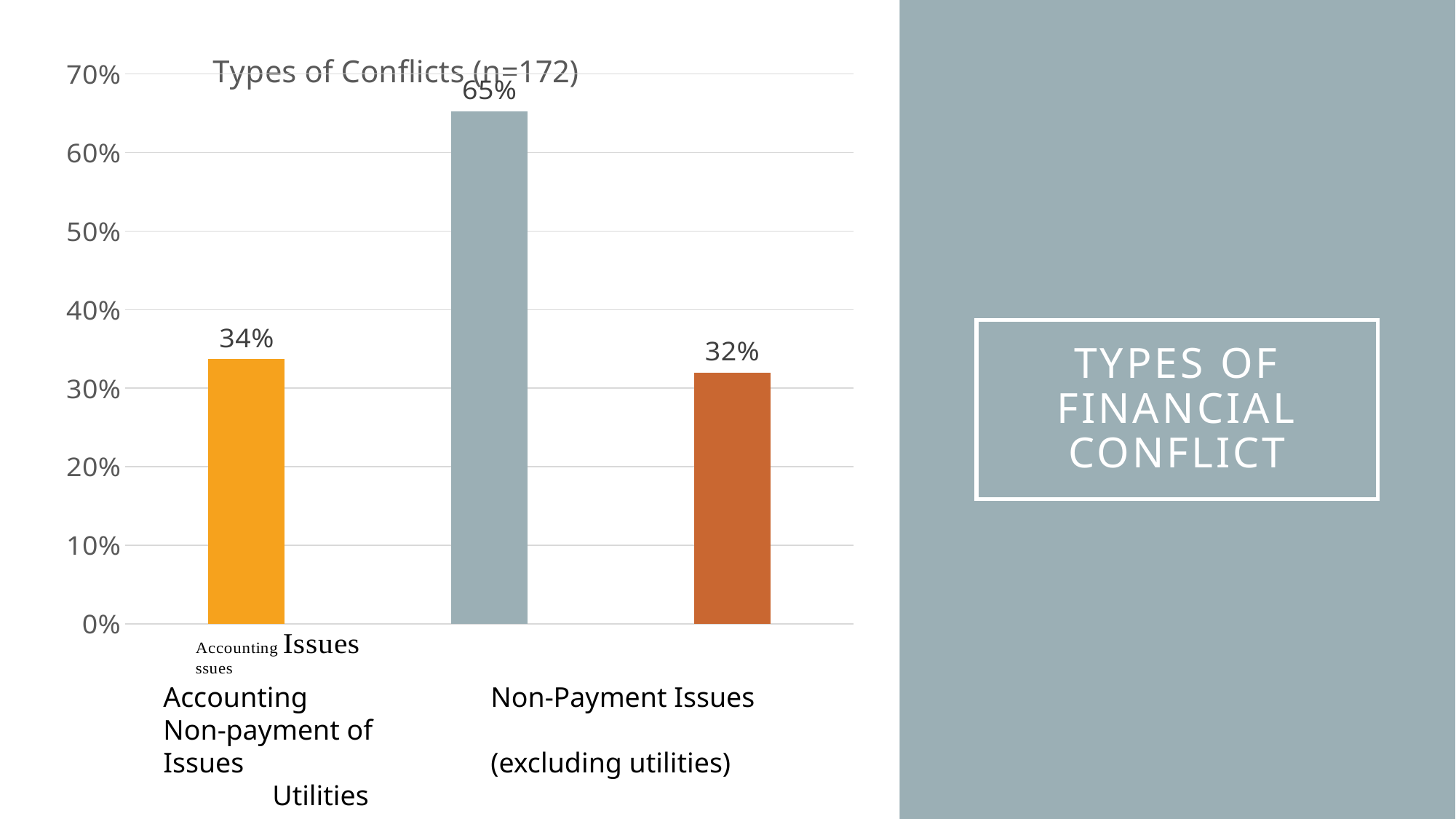
How many percentage points higher is Non-Payment Issues (excluding utilities) than Accounting Issues? 31 percentage points How many bars are plotted in the Types of Conflicts chart? 3 Which category has the highest percentage in the Types of Conflicts chart? Non-Payment Issues (excluding utilities) Is the value for Non-Payment Issues (excluding utilities) greater or less than 60%? greater What is the difference between the Accounting Issues bar (34%) and the rightmost bar (32%)? 2 percentage points What value is labelled on the rightmost (dark orange) bar of the chart? 32% Which bar in the chart has the lowest value? The rightmost (dark orange) bar, 32% What is the title of the chart on the slide? Types of Conflicts (n=172) What percentage is shown for Non-Payment Issues (excluding utilities)? 65% Which is larger: the Accounting Issues bar or the rightmost dark orange bar? Accounting Issues What percentage is shown for Accounting Issues in the Types of Conflicts chart? 34% What kind of chart is shown on the slide? Bar chart